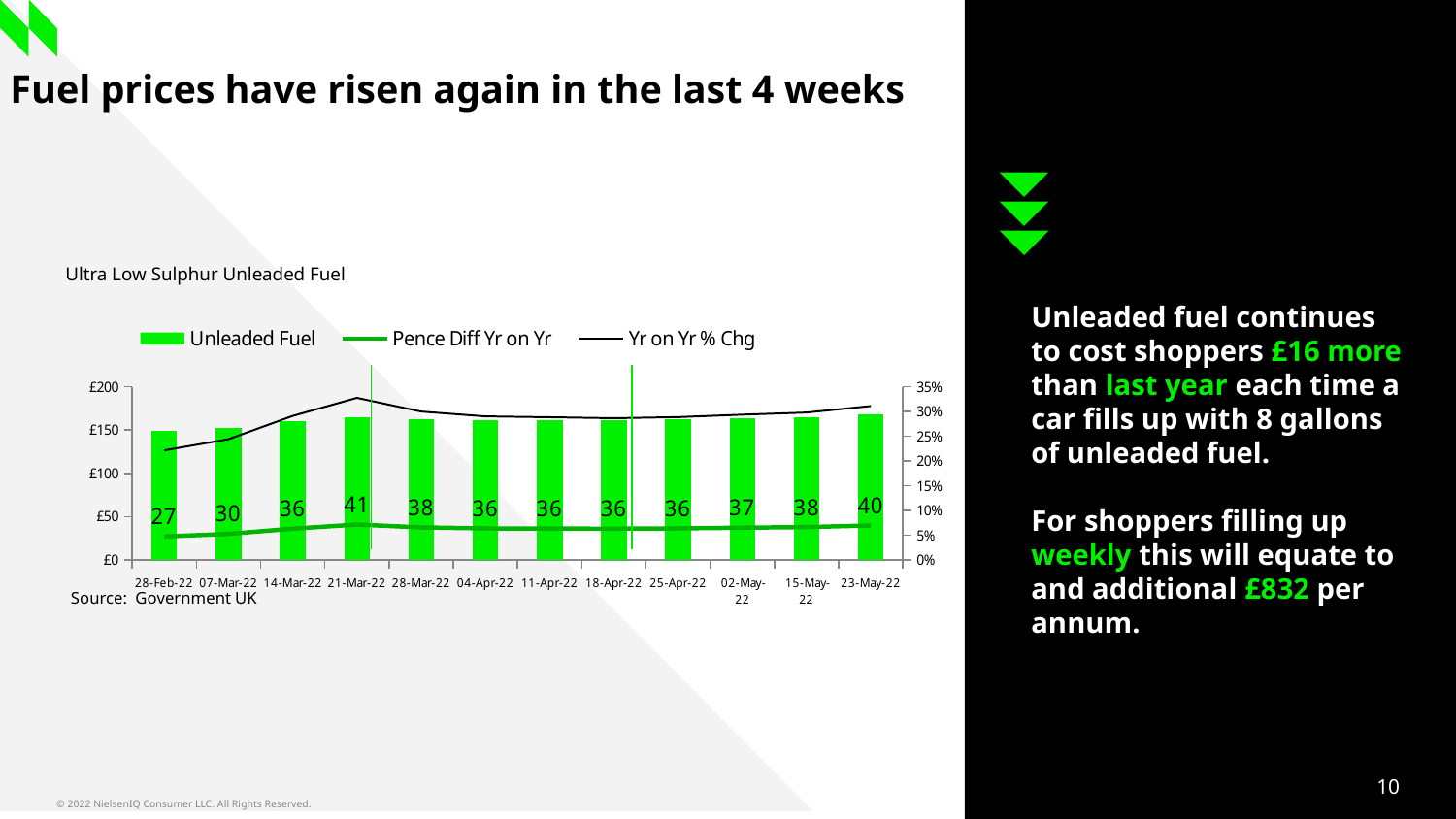
Which has the larger Pence Diff Yr on Yr value, 02-May-22 or 23-May-22? 23-May-22 What is the Pence Diff Yr on Yr value for 23-May-22? 40 What kind of chart is shown on the slide? Combination bar and line chart How many series does the chart legend list? 3 Which date has the lowest Pence Diff Yr on Yr value? 28-Feb-22 What is the Pence Diff Yr on Yr value for 28-Feb-22? 27 What is the difference between the Pence Diff Yr on Yr values for 21-Mar-22 and 28-Feb-22? 14 Do the Unleaded Fuel bars generally rise or fall from 28-Feb-22 to 23-May-22? Rise What is the Pence Diff Yr on Yr value for 21-Mar-22? 41 Which date has the highest Pence Diff Yr on Yr value? 21-Mar-22 How many dates are shown on the x axis of the chart? 12 Is the Unleaded Fuel value for 23-May-22 greater or less than £150? greater